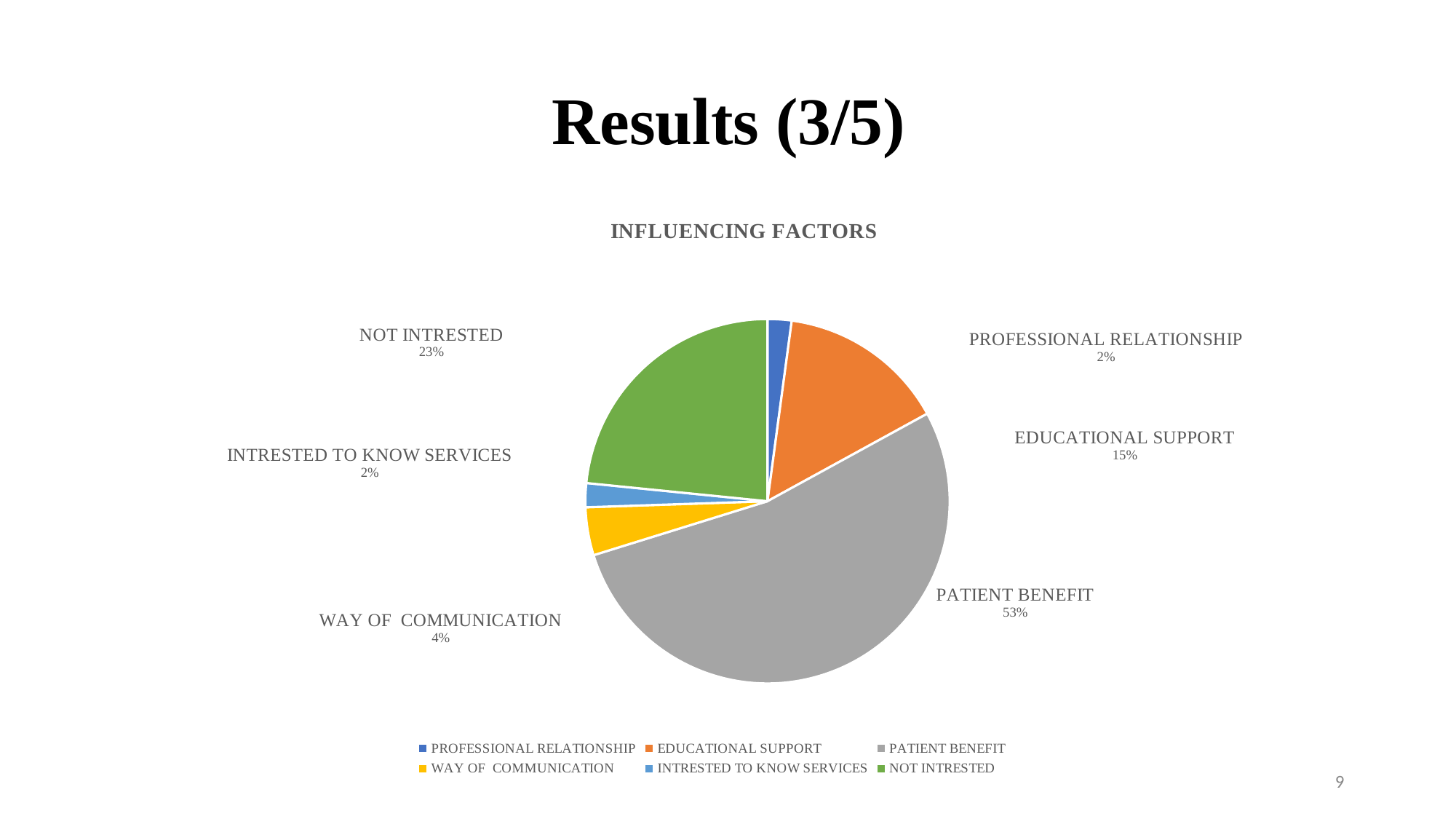
Which is larger, the share for EDUCATIONAL SUPPORT or the share for WAY OF COMMUNICATION? EDUCATIONAL SUPPORT What colour is the PATIENT BENEFIT slice? Grey How many categories are shown in the pie chart? 6 What is the difference in percentage points between NOT INTRESTED and EDUCATIONAL SUPPORT? 8 Which category has the largest slice of the pie? PATIENT BENEFIT What is the title of the chart? INFLUENCING FACTORS What share of the pie does PATIENT BENEFIT represent? 53% What is the difference in percentage points between PATIENT BENEFIT and NOT INTRESTED? 30 What percentage is shown for WAY OF COMMUNICATION? 4% What percentage is shown for NOT INTRESTED? 23% What percentage is shown for EDUCATIONAL SUPPORT? 15% What type of chart is shown on the slide? Pie chart